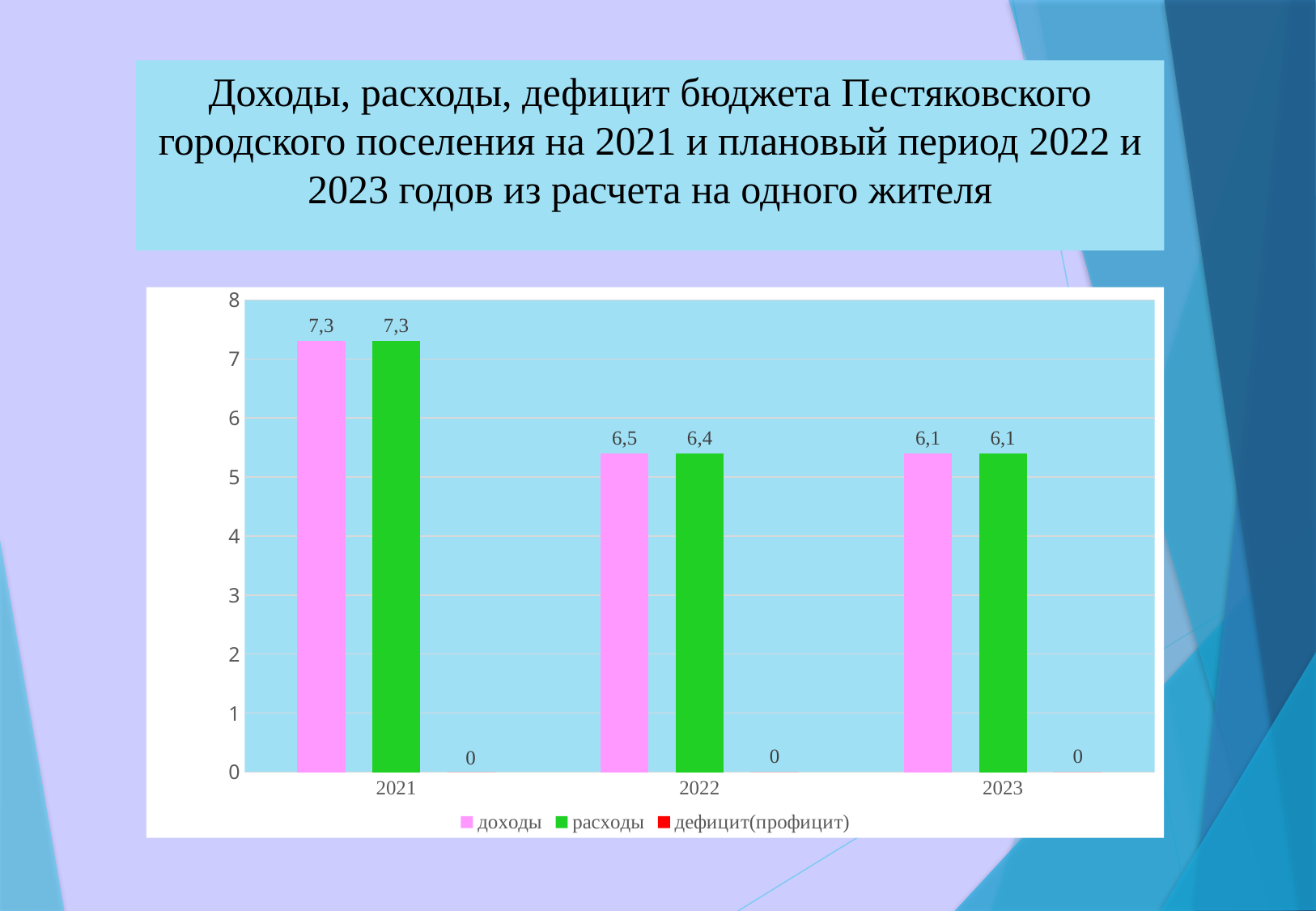
What is the difference between доходы in 2021 and доходы in 2023? 1,2 What is the value for доходы in 2023? 6,1 What is the value for доходы in 2021? 7,3 What is the value for дефицит(профицит) in 2022? 0 What kind of chart is shown on the slide? bar chart How many series does the legend list? 3 In which year is the value for доходы the highest? 2021 What is the value for расходы in 2022? 6,4 What is the difference between доходы and расходы in 2022? 0,1 In which year is the value for расходы the lowest? 2023 Which is larger in 2022, доходы or расходы? доходы How many years are shown on the x axis? 3